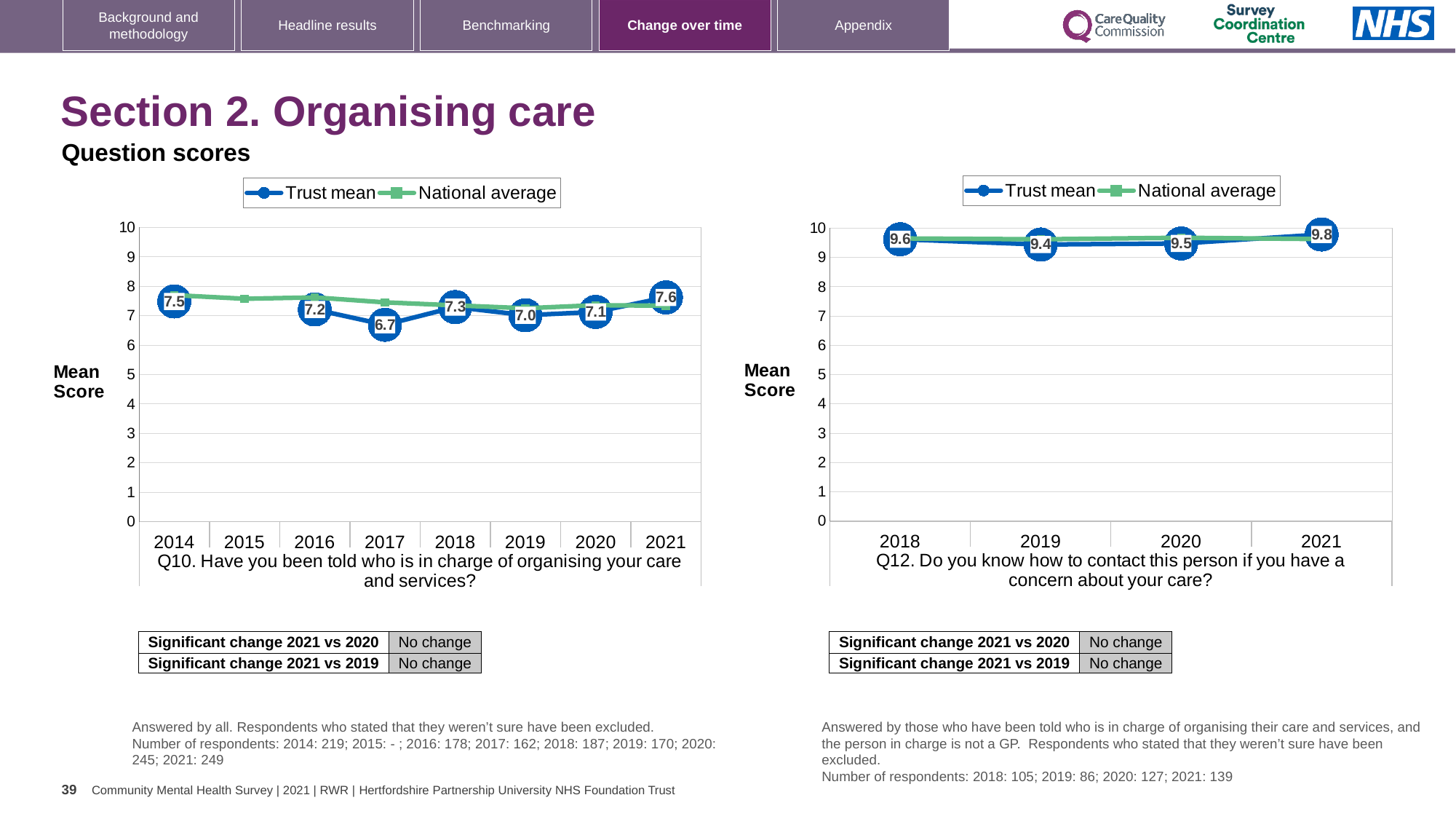
In the Q12 chart on the right, how many years are shown on the x axis? 4 In the Q12 chart on the right, what is the Trust mean for 2019? 9.4 In the Q10 chart on the left, which year has the highest Trust mean? 2021 In the Q10 chart on the left, what is the Trust mean for 2017? 6.7 In the Q12 chart on the right, is the Trust mean for 2020 greater or less than 9? greater In the Q10 chart on the left, what is the difference between the Trust mean in 2021 and in 2020? 0.5 In the Q10 chart on the left, how many series does the legend list? 2 In the Q12 chart on the right, what is the difference between the Trust mean in 2021 and in 2018? 0.2 In the Q12 chart on the right, which year has the highest Trust mean? 2021 In the Q10 chart on the left, which year has the lowest Trust mean? 2017 In the Q10 chart on the left, what is the Trust mean for 2021? 7.6 What kind of chart is the Q12 chart on the right? Line chart